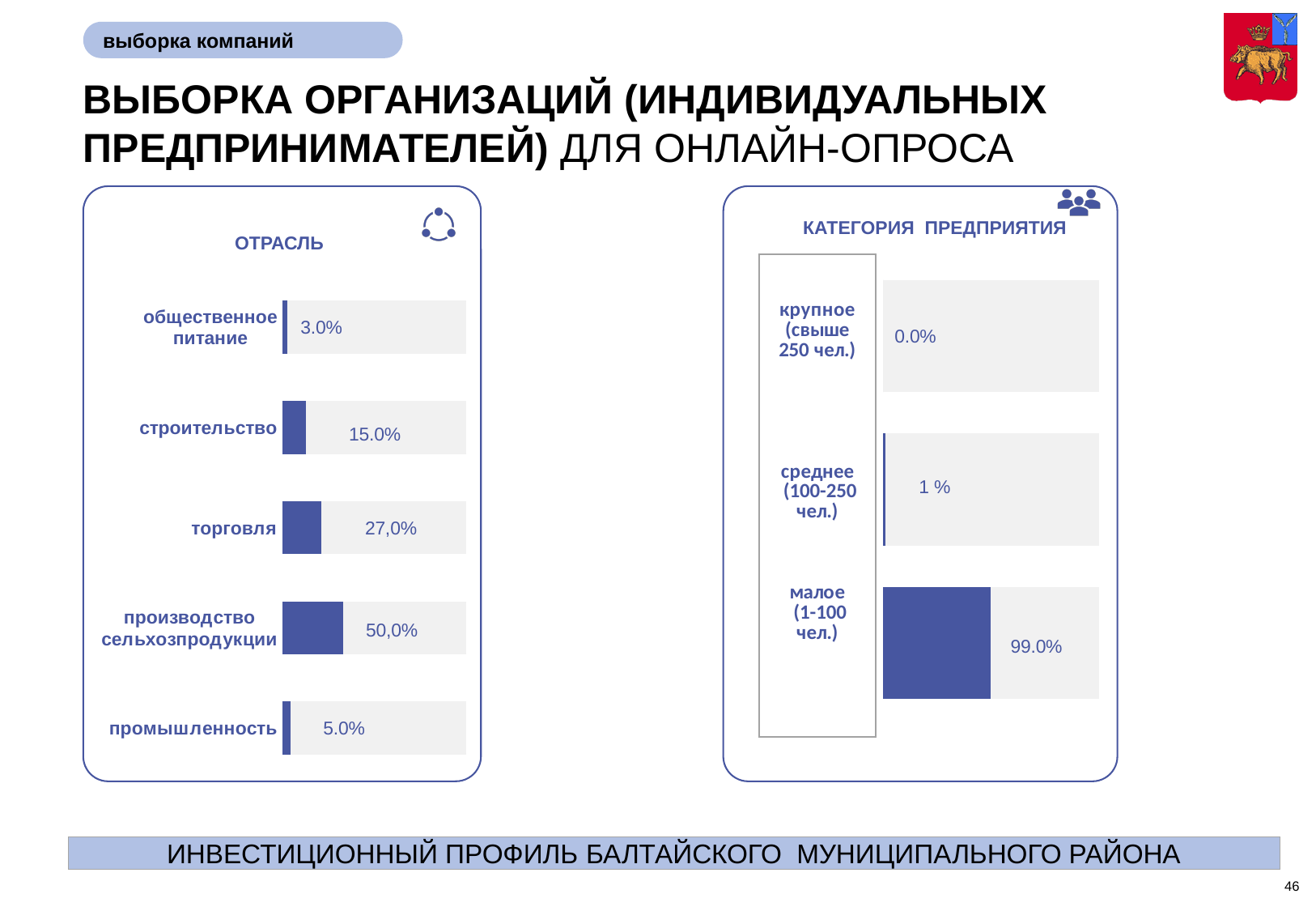
In the ОТРАСЛЬ chart, which category has the lowest value? общественное питание In the КАТЕГОРИЯ ПРЕДПРИЯТИЯ chart, which category has the lowest value? крупное (свыше 250 чел.) In the ОТРАСЛЬ chart, what is the difference between производство сельхозпродукции and торговля? 23,0% In the ОТРАСЛЬ chart, which category has the highest value? производство сельхозпродукции In the ОТРАСЛЬ chart, what is the value for торговля? 27,0% In the КАТЕГОРИЯ ПРЕДПРИЯТИЯ chart, what is the value for малое (1-100 чел.)? 99.0% In the ОТРАСЛЬ chart, which is larger: промышленность or общественное питание? промышленность What kind of chart is the ОТРАСЛЬ chart? bar chart In the ОТРАСЛЬ chart, what is the value for строительство? 15.0% In the КАТЕГОРИЯ ПРЕДПРИЯТИЯ chart, what is the value for среднее (100-250 чел.)? 1 % How many categories are shown in the ОТРАСЛЬ chart? 5 How many categories are shown in the КАТЕГОРИЯ ПРЕДПРИЯТИЯ chart? 3